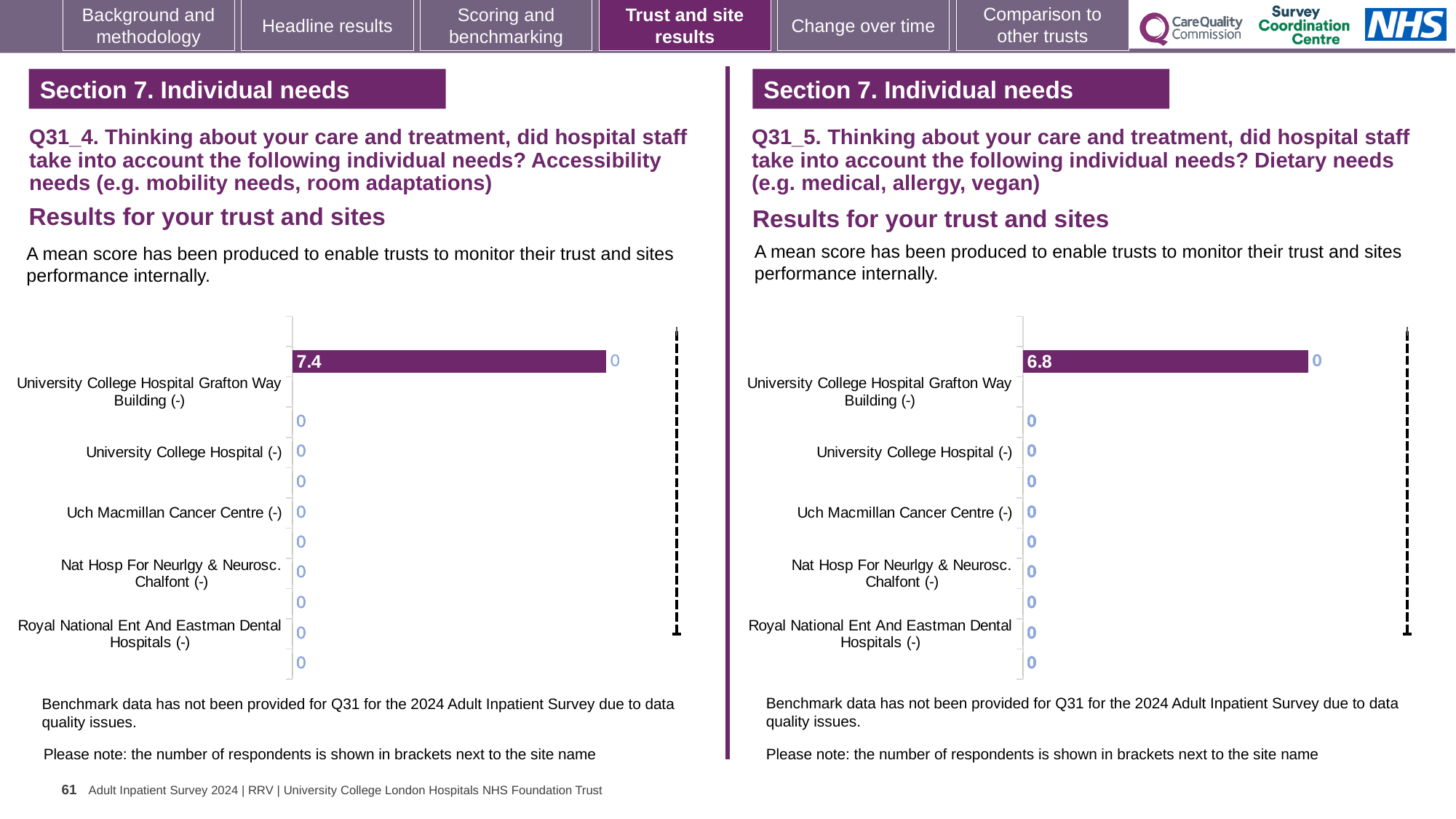
What type of chart is used for the Q31_4 Accessibility needs results on the left? Bar chart How many sites are listed in the Q31_5 Dietary needs chart on the right? 5 In the Q31_4 Accessibility needs chart on the left, what value is shown for Uch Macmillan Cancer Centre? 0 How many sites are listed in the Q31_4 Accessibility needs chart on the left? 5 In the Q31_5 Dietary needs chart on the right, what value is shown for Royal National Ent And Eastman Dental Hospitals? 0